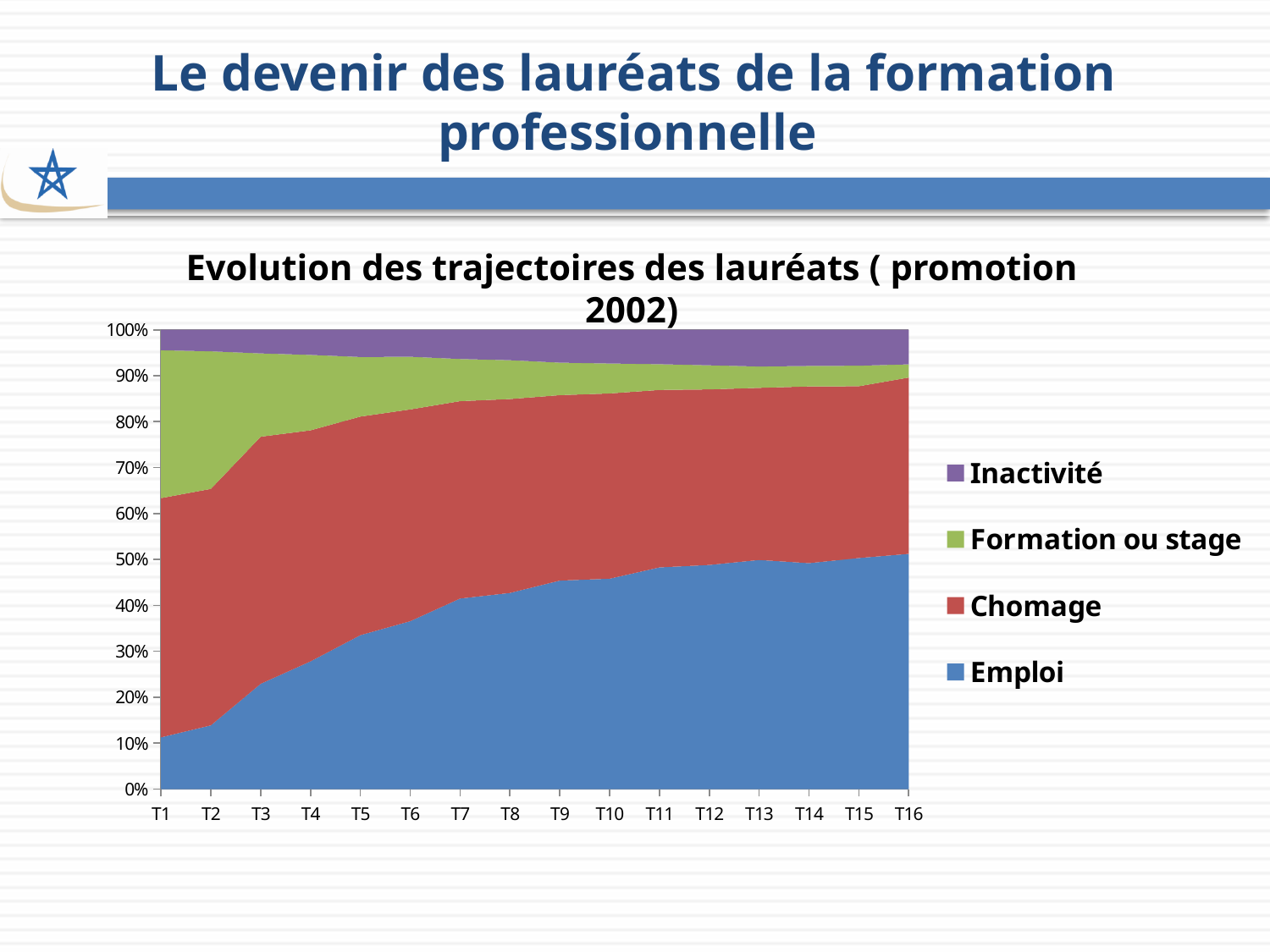
What kind of chart is shown on the slide? Stacked area chart Is the share of Emploi larger at T1 or at T16? T16 Which colour represents the Emploi series in the chart? Blue Is the share of Emploi at T16 greater or less than 40%? greater How many series does the chart legend list? 4 How many time periods are shown on the x axis of the chart? 16 Does the share of Emploi rise or fall from T1 to T16? Rise Which period has the lowest share of Emploi? T1 What is the title of the chart? Evolution des trajectoires des lauréats ( promotion 2002) Is the share of Emploi at T1 greater or less than 20%? less Is the share of Formation ou stage at T1 greater or less than 20%? greater Does the share of Formation ou stage rise or fall from T1 to T16? Fall